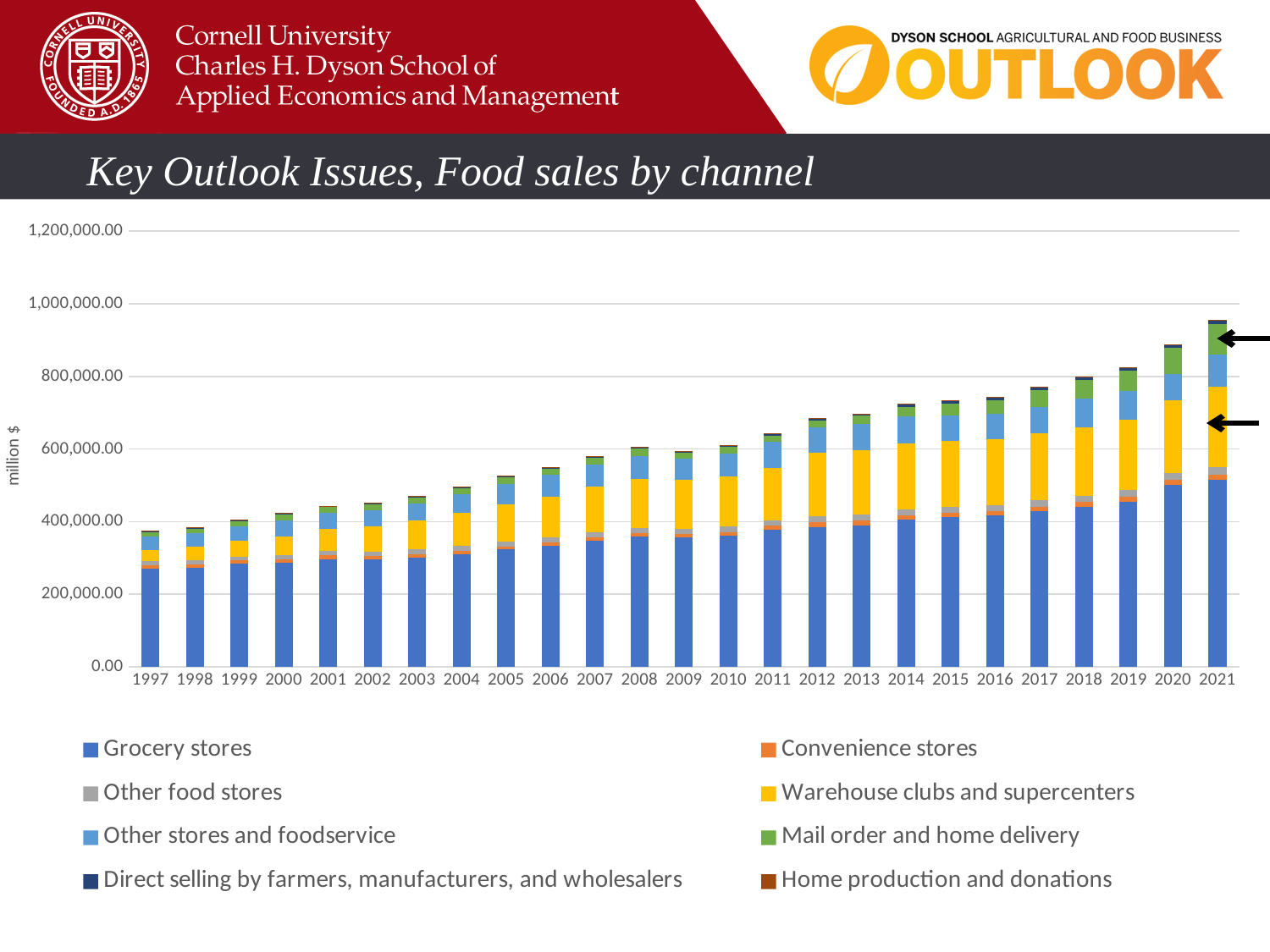
Which year has the highest total food sales? 2021 Do total food sales generally rise or fall from 1997 to 2021? Rise Is the total food sales value for 2015 greater or less than 800,000.00? less Is the total food sales value for 2021 greater or less than 800,000.00? greater How many series does the chart's legend list? 8 Which year has larger total food sales, 2020 or 2021? 2021 How many years are shown along the x axis of the chart? 25 Is the total food sales value for 1997 greater or less than 400,000.00? less Which year has the lowest total food sales? 1997 What kind of chart is shown on the slide? Stacked bar chart What is the label on the chart's y axis? million $